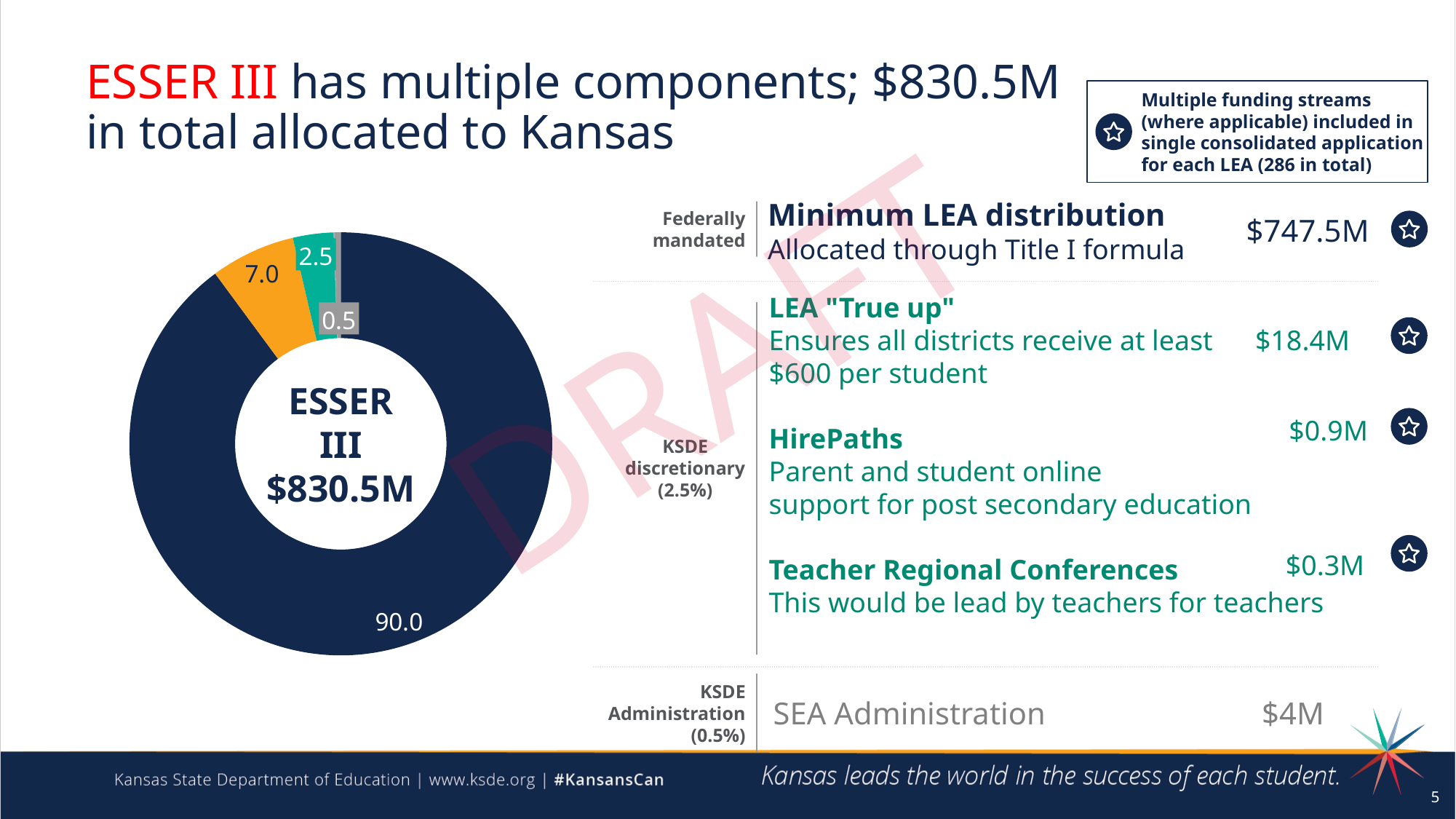
What text label appears in the centre of the donut chart above the dollar amount? ESSER III What is the difference between the largest slice (90.0) and the orange slice (7.0) in the donut chart? 83.0 What value is labelled on the teal slice of the donut chart? 2.5 How many slices does the donut chart have? 4 What value is labelled on the orange slice of the donut chart? 7.0 Which is larger in the donut chart, the orange slice or the teal slice? the orange slice (7.0) What kind of chart is shown on the left of the slide? donut (pie) chart What colour is the largest slice of the donut chart? dark navy blue What is the difference between the orange slice (7.0) and the teal slice (2.5) in the donut chart? 4.5 What is the value of the smallest slice in the donut chart? 0.5 What is the value of the largest slice in the donut chart? 90.0 What total amount is printed in the centre of the donut chart? $830.5M